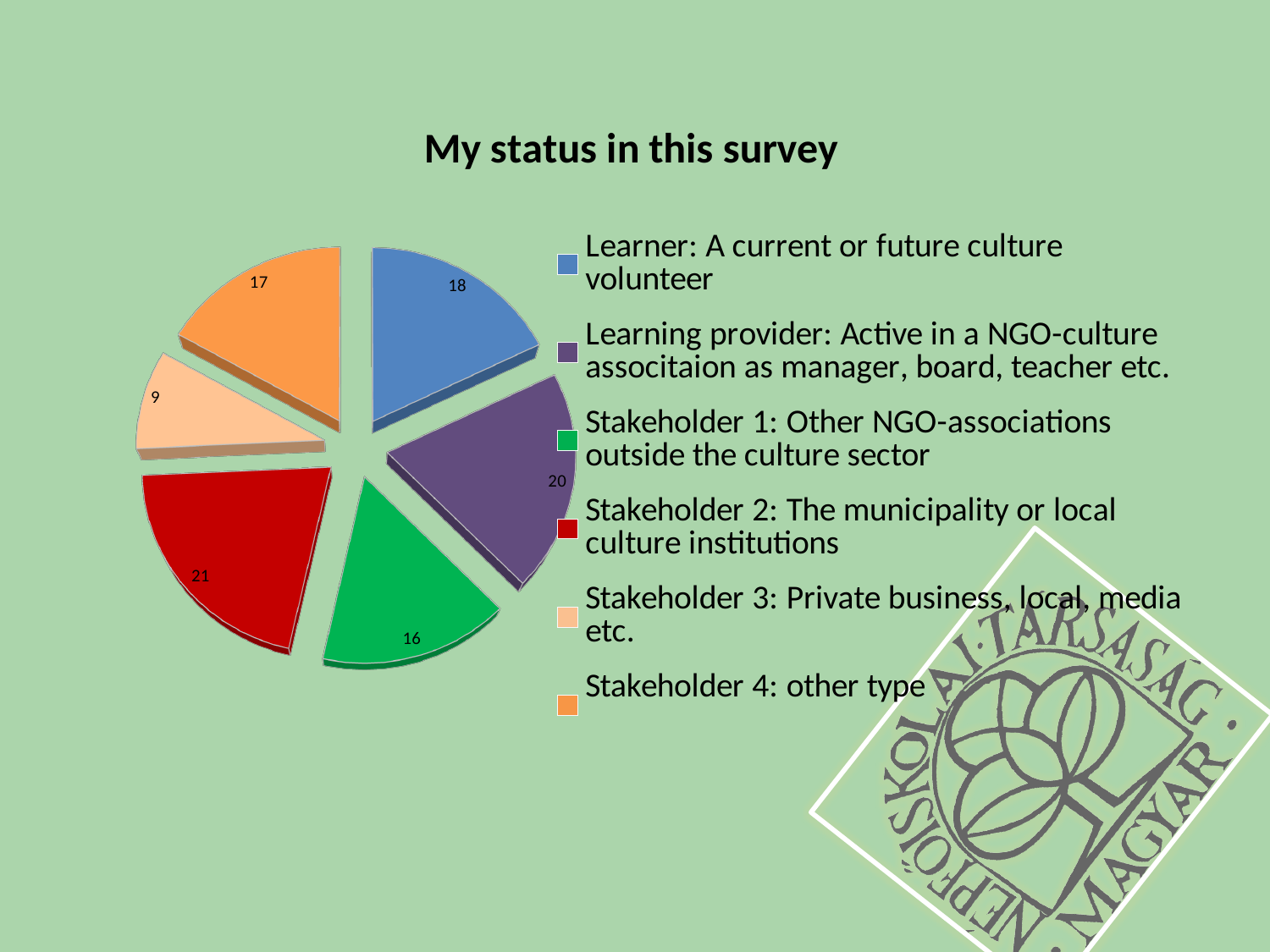
What colour is the slice for "Stakeholder 2: The municipality or local culture institutions"? Red What is the value for "Learning provider: Active in a NGO-culture associtaion as manager, board, teacher etc."? 20 What is the difference between the value for Stakeholder 2 and the value for Stakeholder 3? 12 Which category has the largest slice? Stakeholder 2: The municipality or local culture institutions Which is larger: the value for Learner or the value for Stakeholder 4: other type? Learner What is the title of the chart? My status in this survey How many categories does the pie chart have? 6 What is the value for "Stakeholder 3: Private business, local, media etc."? 9 What is the value for "Learner: A current or future culture volunteer"? 18 What is the value for "Stakeholder 1: Other NGO-associations outside the culture sector"? 16 Which category has the smallest slice? Stakeholder 3: Private business, local, media etc. What type of chart is shown on the slide? Pie chart